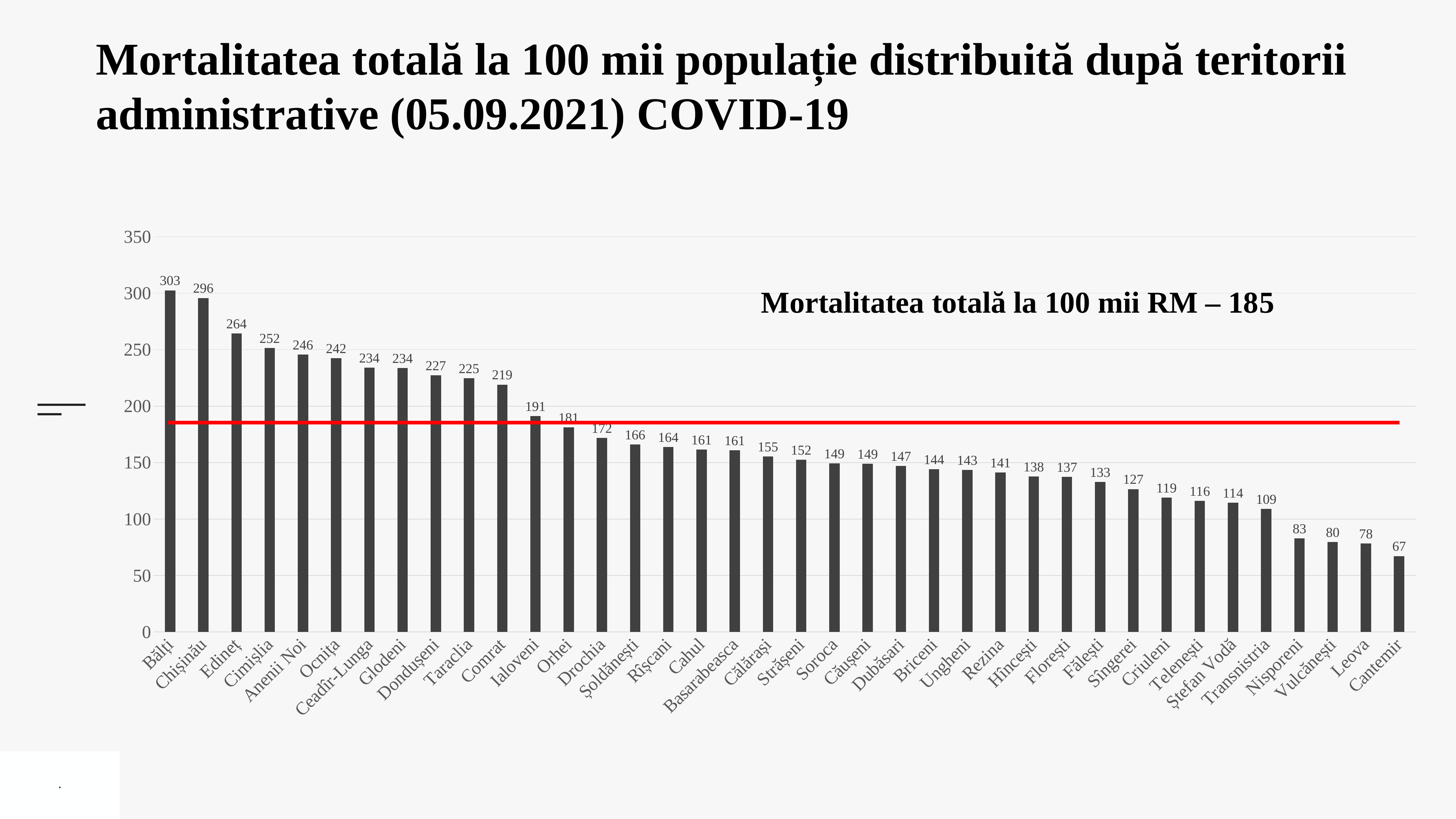
What is the difference between the values for Bălți and Chișinău? 7 What is the value for Cahul? 161 Which territory has the highest value? Bălți What is the difference between the values for Edineț and Leova? 186 What is the value for Chișinău? 296 Which has a larger value, Orhei or Drochia? Orhei How many territories are shown on the chart? 38 Which territory has the lowest value? Cantemir What is the value for Cantemir? 67 What is the value for Bălți? 303 What value does the red horizontal line on the chart represent, according to the text on the slide? 185 What kind of chart is shown on the slide? Bar chart